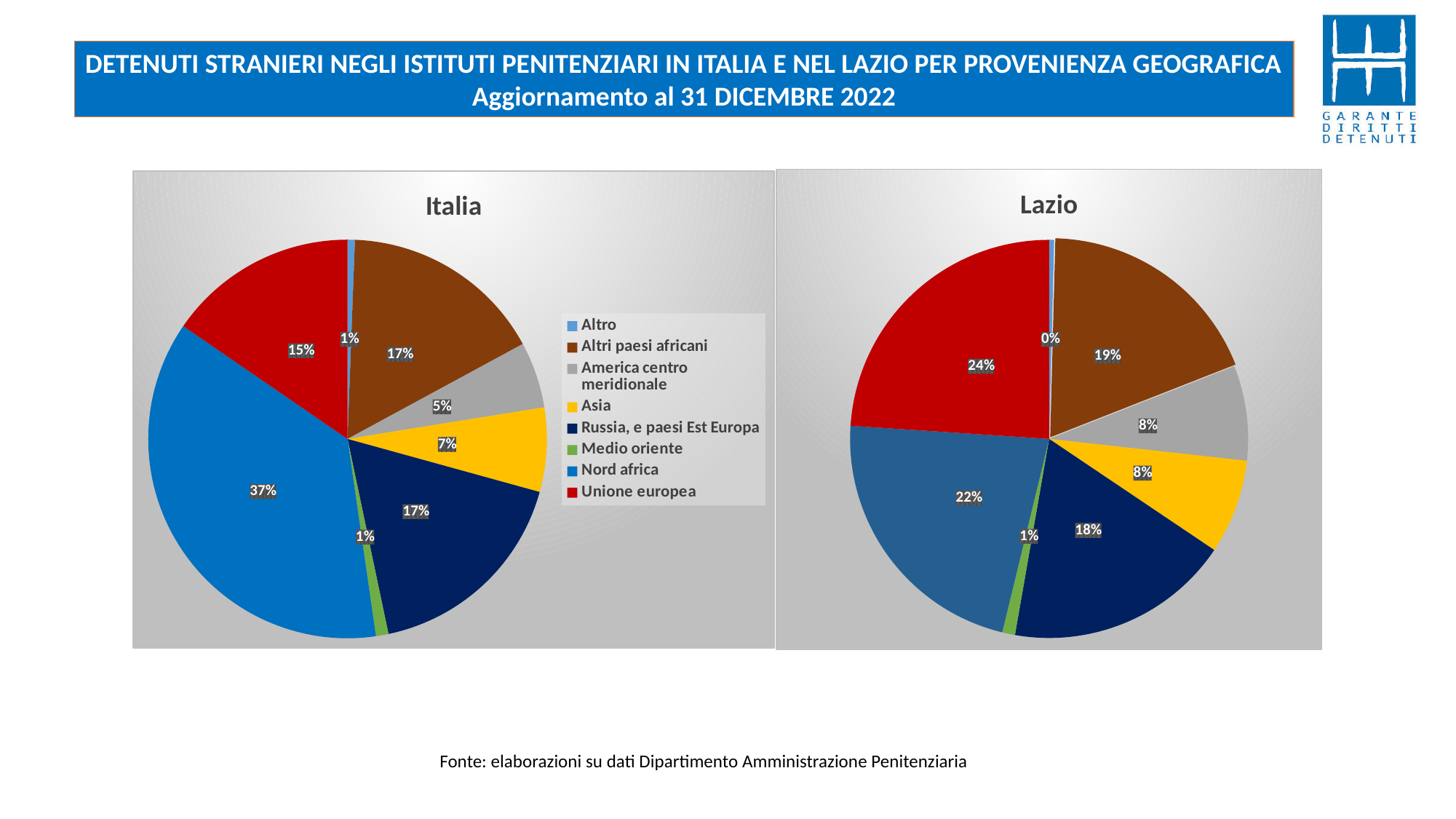
In the Lazio pie chart, which category has the largest share? Unione europea In the Lazio pie chart, which is larger: Altri paesi africani or Russia, e paesi Est Europa? Altri paesi africani What kind of charts are shown on the slide? Pie charts In the Lazio pie chart, what share is Russia, e paesi Est Europa? 18% How many categories does the legend list? 8 In the Lazio pie chart, what share is Unione europea? 24% In the Italia pie chart, what is the difference between the Nord africa share and the Unione europea share? 22 percentage points In the Italia pie chart, what share is Nord africa? 37% In the Italia pie chart, which category has the largest share? Nord africa What colour represents Unione europea in the pie charts? Red In the Italia pie chart, what share is Asia? 7% In the Lazio pie chart, which category has the smallest share? Altro